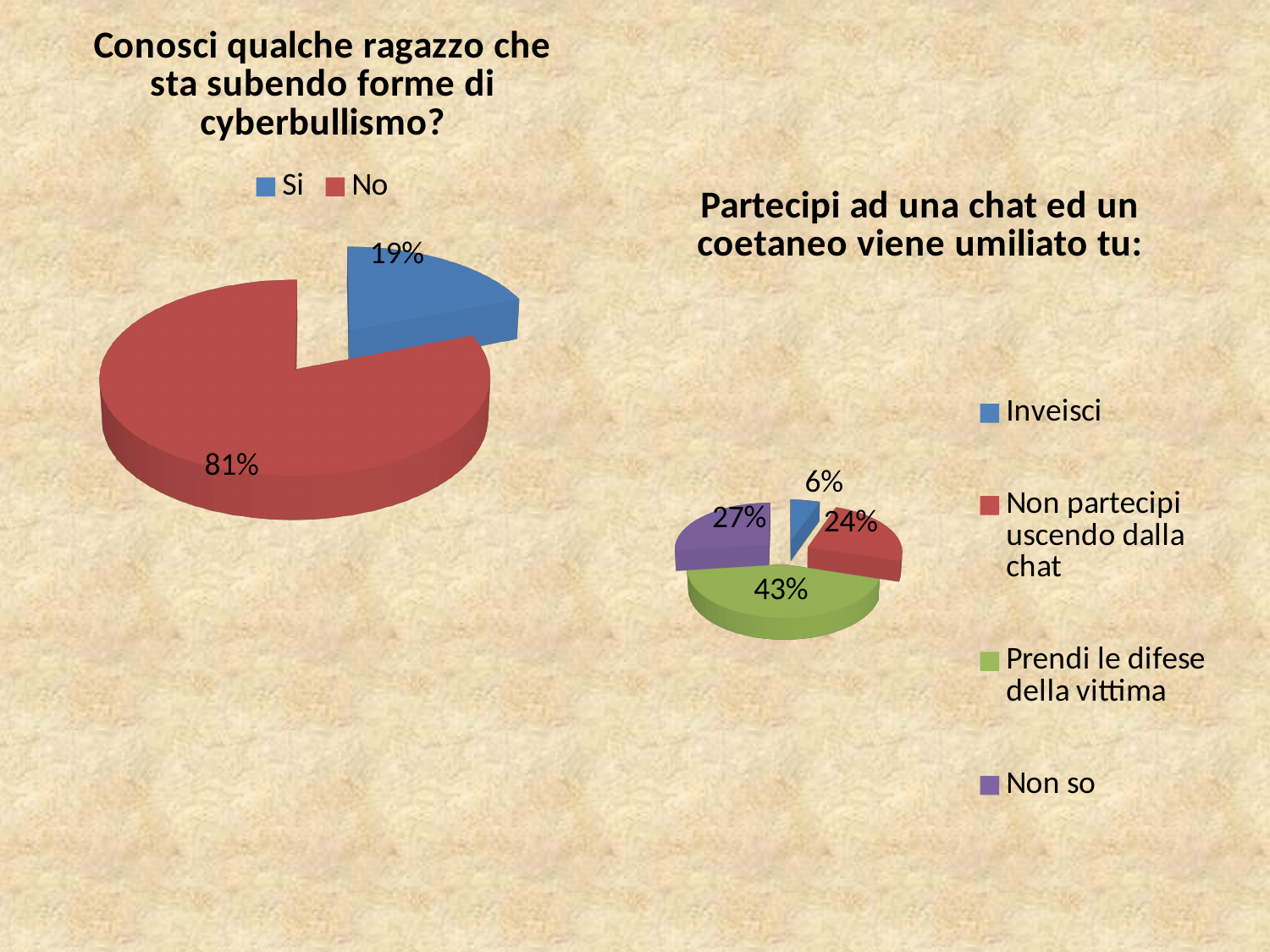
In the right chart 'Partecipi ad una chat ed un coetaneo viene umiliato tu:', which option has the largest share? Prendi le difese della vittima In the right chart 'Partecipi ad una chat ed un coetaneo viene umiliato tu:', which option has the smallest share? Inveisci In the left chart 'Conosci qualche ragazzo che sta subendo forme di cyberbullismo?', what percentage answered 'No'? 81% In the right chart 'Partecipi ad una chat ed un coetaneo viene umiliato tu:', what percentage chose 'Prendi le difese della vittima'? 43% In the left chart 'Conosci qualche ragazzo che sta subendo forme di cyberbullismo?', what is the difference in percentage points between 'No' and 'Si'? 62 What kind of chart is the left chart 'Conosci qualche ragazzo che sta subendo forme di cyberbullismo?'? Pie chart In the right chart 'Partecipi ad una chat ed un coetaneo viene umiliato tu:', how many options does the legend list? 4 In the left chart 'Conosci qualche ragazzo che sta subendo forme di cyberbullismo?', what percentage answered 'Si'? 19% In the right chart 'Partecipi ad una chat ed un coetaneo viene umiliato tu:', which is larger: 'Non partecipi uscendo dalla chat' or 'Non so'? Non so In the left chart 'Conosci qualche ragazzo che sta subendo forme di cyberbullismo?', which answer has the larger share? No In the right chart 'Partecipi ad una chat ed un coetaneo viene umiliato tu:', what percentage chose 'Inveisci'? 6% In the right chart 'Partecipi ad una chat ed un coetaneo viene umiliato tu:', what percentage chose 'Non so'? 27%